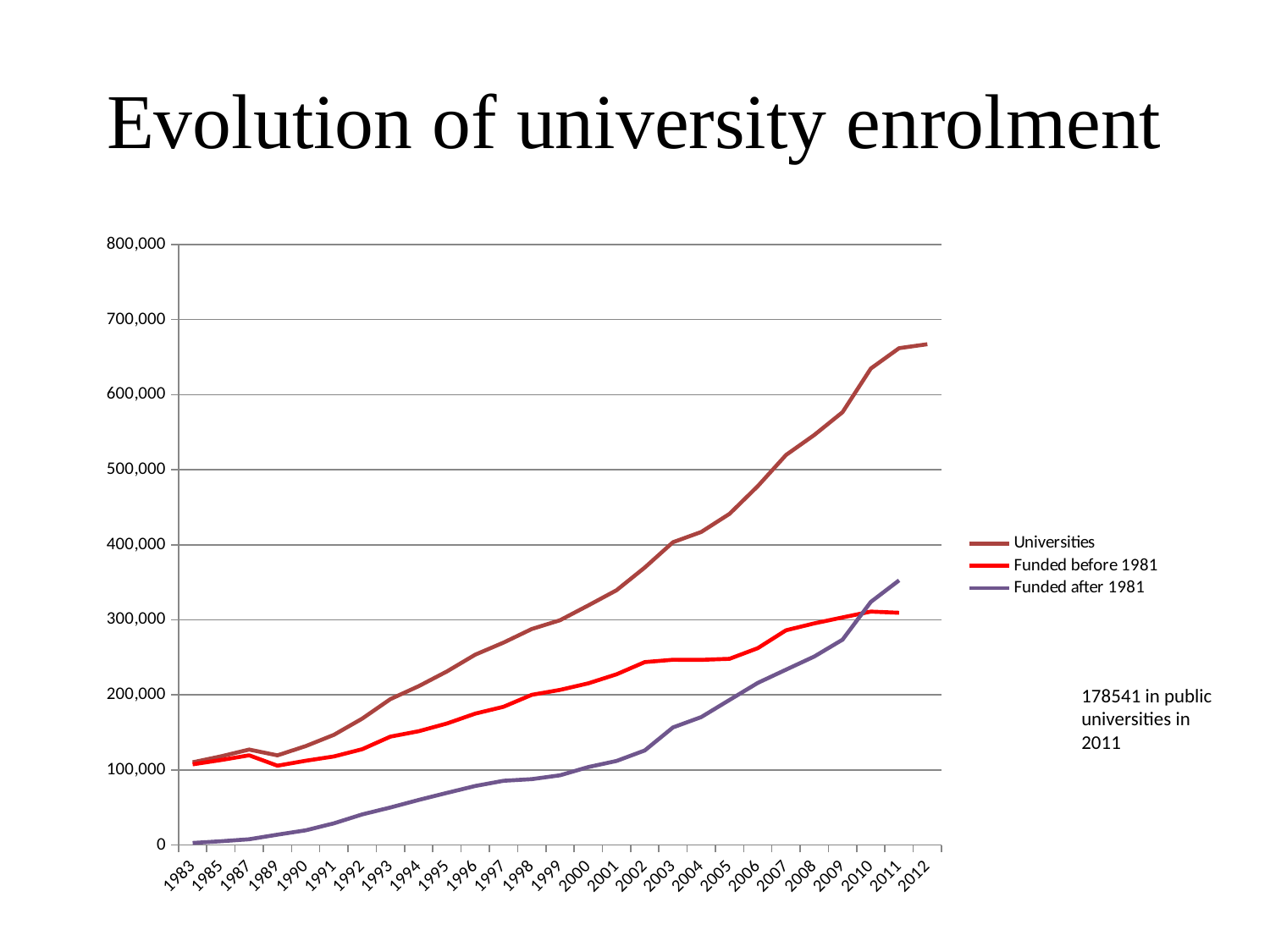
In 2011, which is larger: Funded before 1981 or Funded after 1981? Funded after 1981 Which series is plotted in red? Funded before 1981 Which series has the highest values across the whole period? Universities Is the value for Universities in 2007 greater or less than 500,000? greater Is the value for Funded before 1981 in 2005 greater or less than 300,000? less What kind of chart is shown on the slide? Line chart What is the title of the chart? Evolution of university enrolment How many series does the legend list? 3 Which series has the lowest value in 1983? Funded after 1981 Is the value for Funded after 1981 in 1983 greater or less than 100,000? less Do the values for Universities rise or fall from 1983 to 2012? Rise